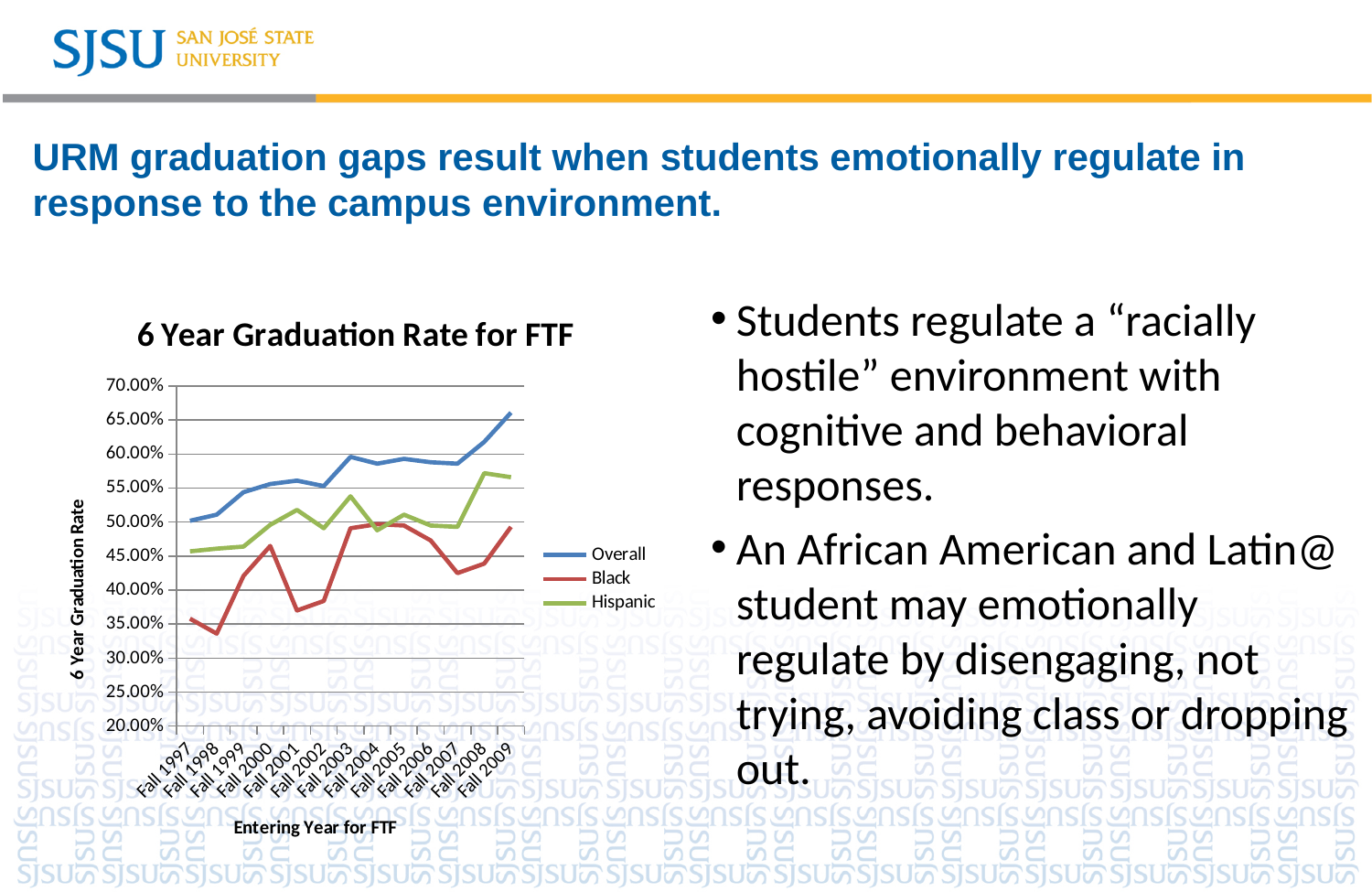
For Fall 2009, which series has the higher graduation rate, Overall or Black? Overall Does the Overall graduation rate generally rise or fall from Fall 1997 to Fall 2009? Rise What kind of chart is shown on the slide? Line chart In which entering year is the Overall 6 year graduation rate highest? Fall 2009 How many entering years are plotted along the x axis of the chart? 13 Is the Overall graduation rate for Fall 2009 greater or less than 60.00%? greater How many series does the legend of the chart list? 3 Is the Black graduation rate for Fall 2001 greater or less than 40.00%? less Is the Black graduation rate for Fall 1998 greater or less than 35.00%? less For Fall 2000, which series has the higher graduation rate, Black or Hispanic? Hispanic What is the title of the chart? 6 Year Graduation Rate for FTF In which entering year is the Black 6 year graduation rate lowest? Fall 1998